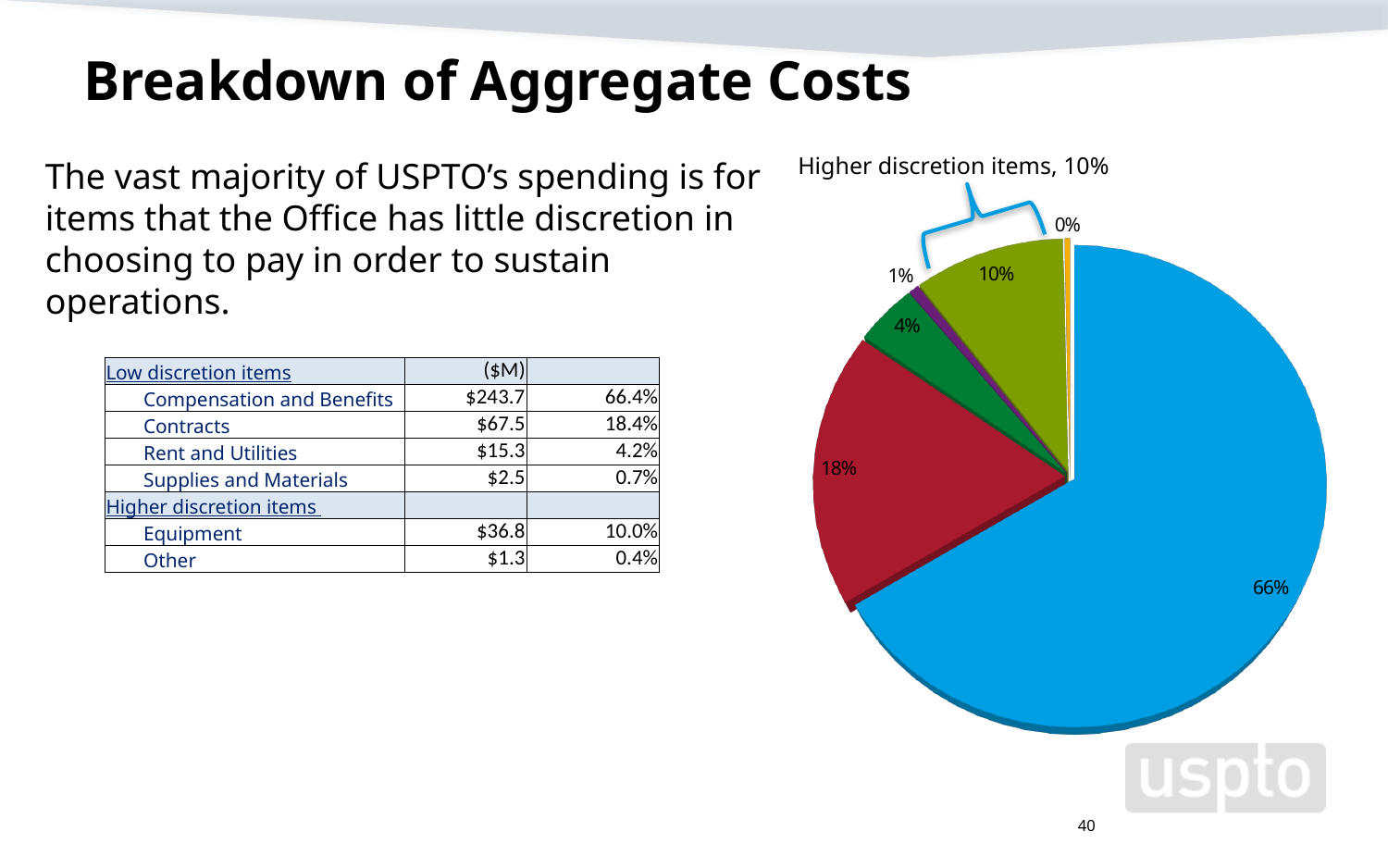
Which is larger on the pie chart, the 10% slice or the 4% slice? the 10% slice What colour is the largest slice of the pie chart? blue What is the second-largest share shown on the pie chart? 18% What is the difference between the largest slice (66%) and the 18% slice? 48 percentage points What kind of chart is shown on the slide? pie chart What share is labelled on the purple slice of the pie chart? 1% What is the largest share shown on the pie chart? 66% What share is labelled on the olive-green slice of the pie chart? 10% What share is labelled on the green slice of the pie chart? 4% According to the annotation on the pie chart, what share do the higher discretion items make up? 10% What share is labelled on the orange slice of the pie chart? 0% How many slices does the pie chart have? 6